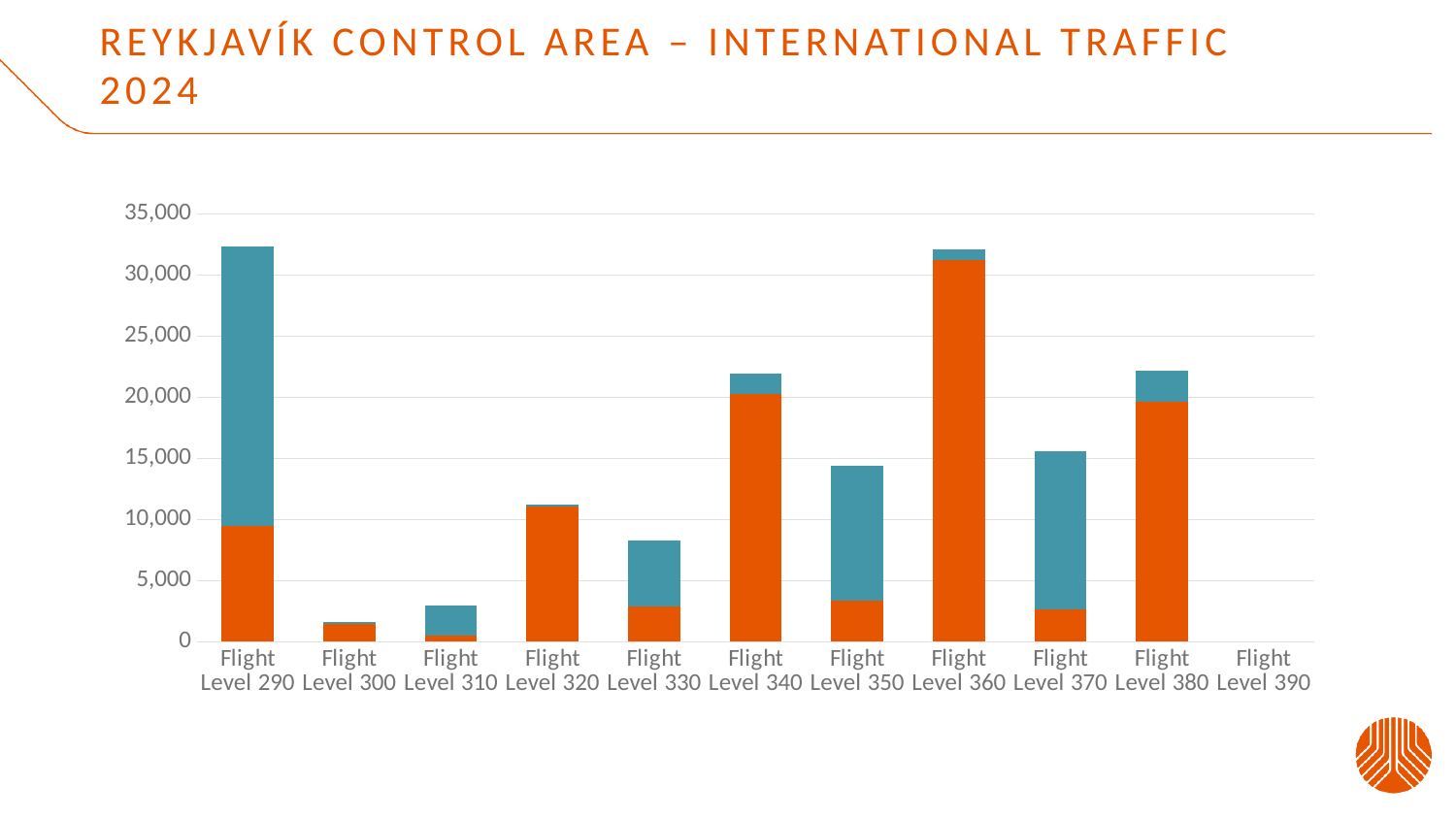
Is the total value for Flight Level 290 greater or less than 30,000? greater Is the total value for Flight Level 380 greater or less than 20,000? greater Is the total value for Flight Level 300 greater or less than 5,000? less What is the title of the slide containing the chart? Reykjavík Control Area – International Traffic 2024 What kind of chart is shown on the slide? Stacked bar chart Which has the larger total bar, Flight Level 300 or Flight Level 310? Flight Level 310 Which has the larger total bar, Flight Level 320 or Flight Level 330? Flight Level 320 How many flight level categories are shown on the x axis? 11